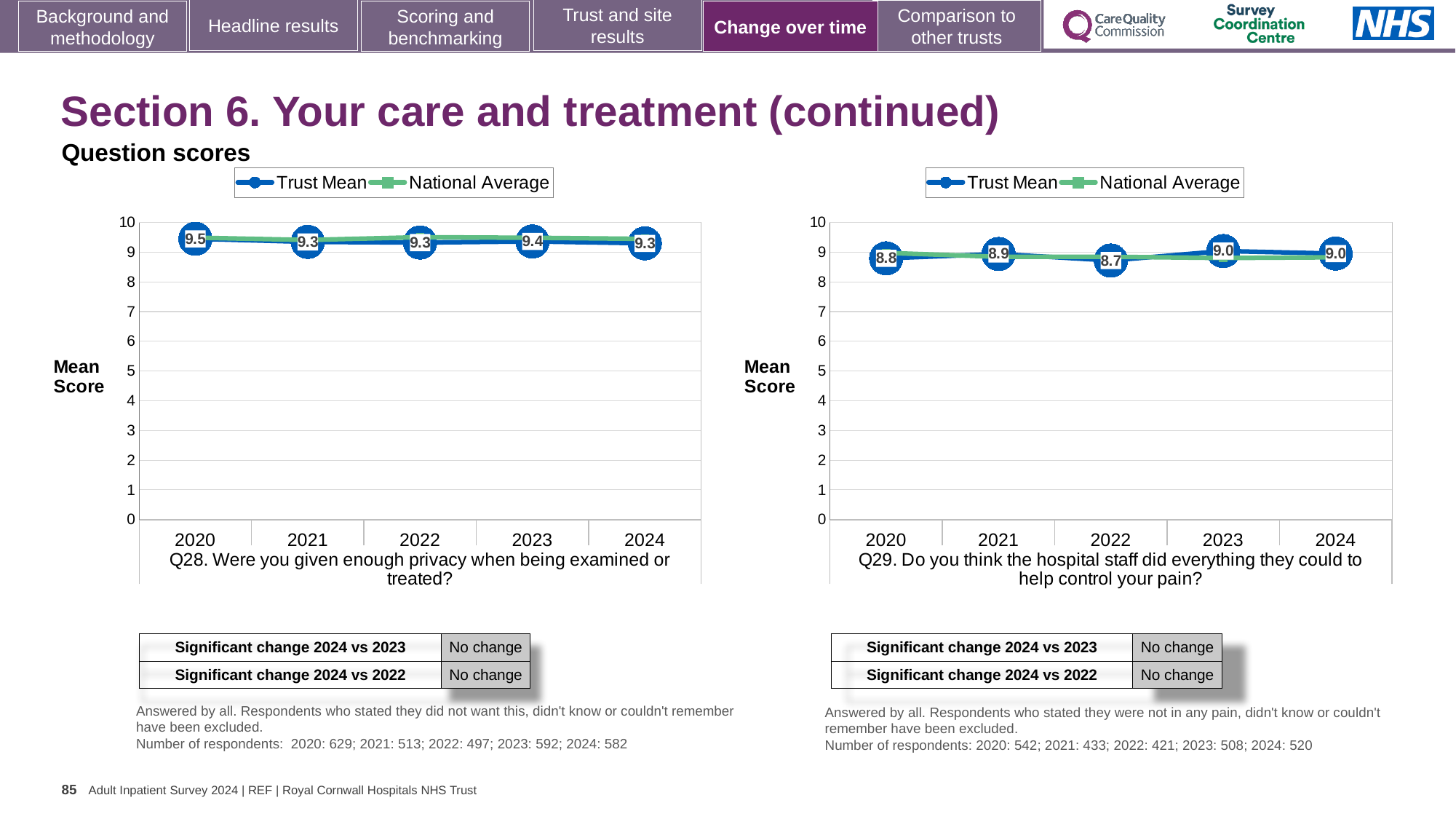
How many years are plotted on the x axis of the Q28 chart (left)? 5 Is the Trust Mean for 2021 in the Q29 chart (right) greater or less than 8? greater In the Q28 chart (left), which year has the highest Trust Mean? 2020 In the Q28 chart (left), what is the difference between the Trust Mean for 2020 and 2024? 0.2 In the Q29 chart (right), what is the Trust Mean for 2022? 8.7 In the Q29 chart (right), which year has the lowest Trust Mean? 2022 In the Q28 chart (left), what is the Trust Mean for 2020? 9.5 What kind of chart is the Q28 chart (left)? Line chart How many series does the legend of the Q29 chart (right) list? 2 In the Q28 chart (left), what is the Trust Mean for 2023? 9.4 In the Q29 chart (right), what is the difference between the Trust Mean for 2023 and 2022? 0.3 In the Q29 chart (right), what is the Trust Mean for 2024? 9.0